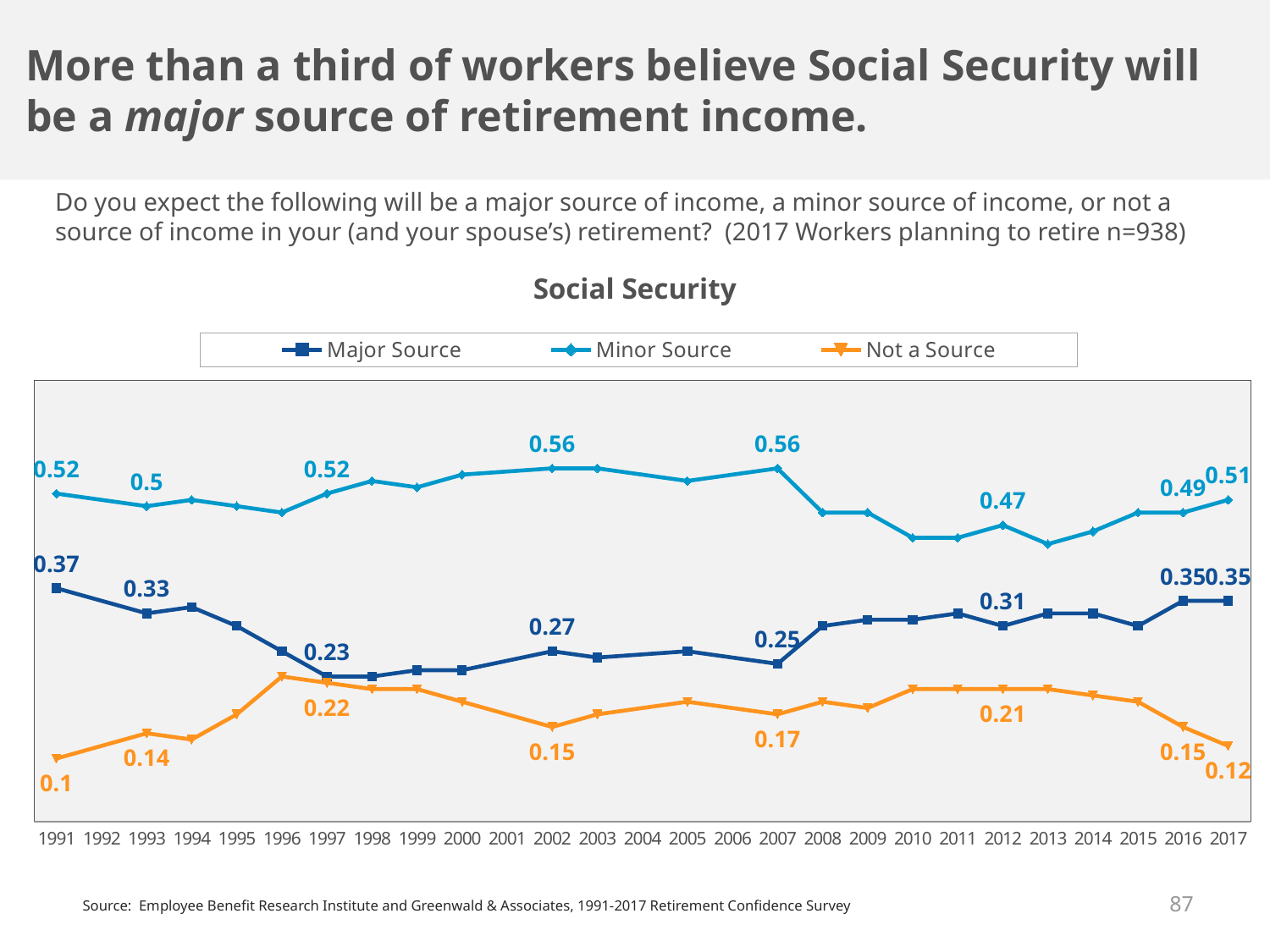
How many series does the legend list? 3 What is the value for Minor Source in 2002? 0.56 Does the Major Source line rise or fall from 1991 to 1997? Fall What is the difference between the Major Source values in 1991 and 2017? 0.02 What is the value for Not a Source in 1991? 0.1 Which series has the highest value in 2017? Minor Source What is the value for Major Source in 1997? 0.23 What kind of chart is shown on the slide? Line chart What is the value for Major Source in 2017? 0.35 What is the value for Not a Source in 2007? 0.17 What is the value for Minor Source in 2012? 0.47 What is the difference between the Not a Source values in 2016 and 2017? 0.03